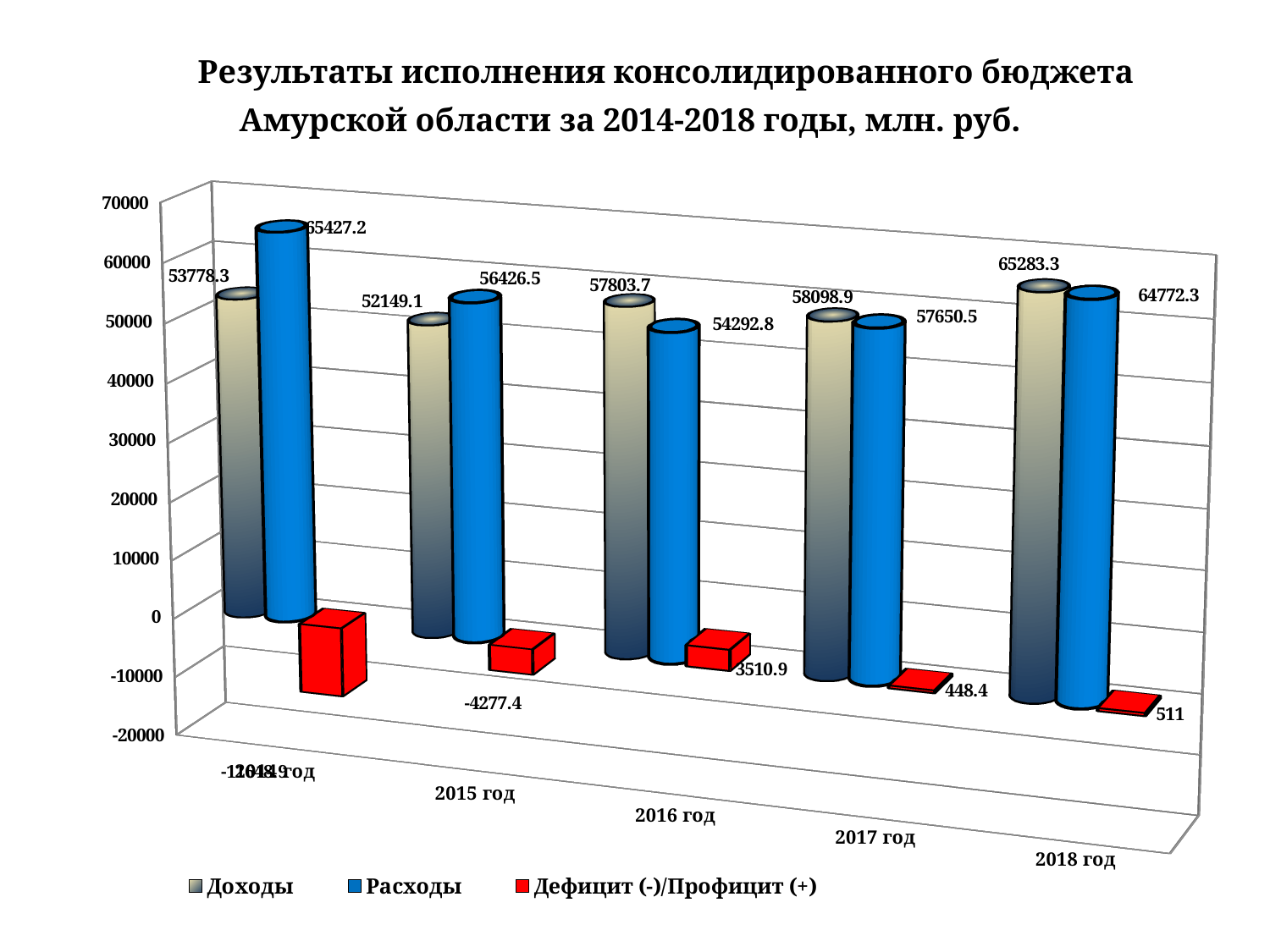
What is the difference between Доходы and Расходы in 2016 год? 3510.9 Is the value of Расходы for 2014 год greater or less than 60000? greater What is the value of Дефицит (-)/Профицит (+) for 2017 год? 448.4 What kind of chart is shown on the slide? bar chart Which is larger in 2015 год, Доходы or Расходы? Расходы What is the value of Расходы for 2014 год? 65427.2 What is the value of Расходы for 2018 год? 64772.3 In which year is Расходы the lowest? 2016 год How many years are shown on the x axis? 5 What is the value of Доходы for 2015 год? 52149.1 How many series does the legend list? 3 In which year is Доходы the highest? 2018 год